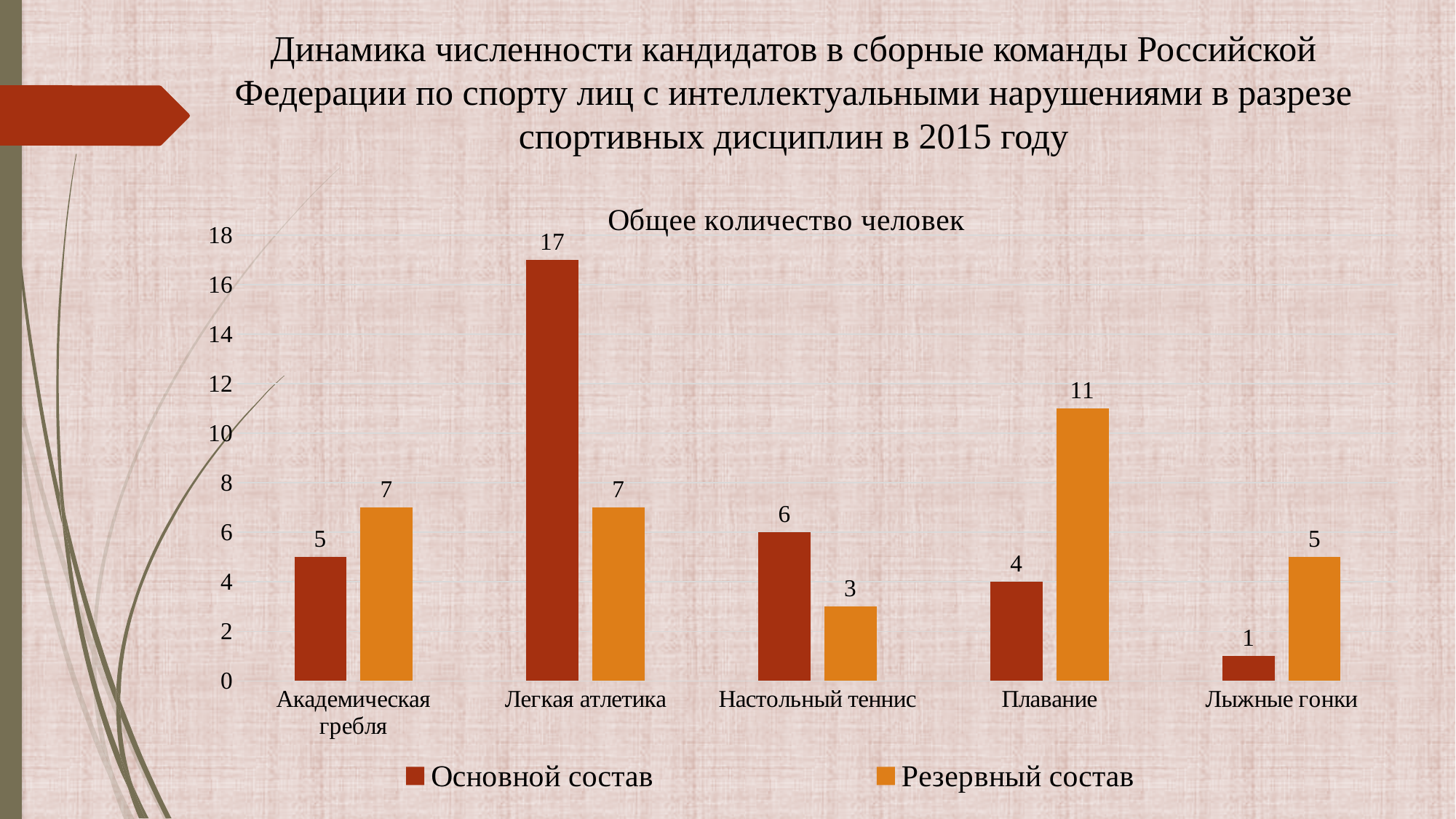
What is the value for Основной состав in Легкая атлетика? 17 What is the value for Резервный состав in Плавание? 11 How many categories are shown on the x axis? 5 Which is larger in Плавание: Основной состав or Резервный состав? Резервный состав What is the difference between Основной состав and Резервный состав in Легкая атлетика? 10 What kind of chart is shown on the slide? Bar chart Which category has the highest value for Основной состав? Легкая атлетика What is the value for Резервный состав in Настольный теннис? 3 How many series does the legend list? 2 What is the value for Основной состав in Лыжные гонки? 1 Which category has the lowest value for Резервный состав? Настольный теннис What is the title of the chart? Общее количество человек